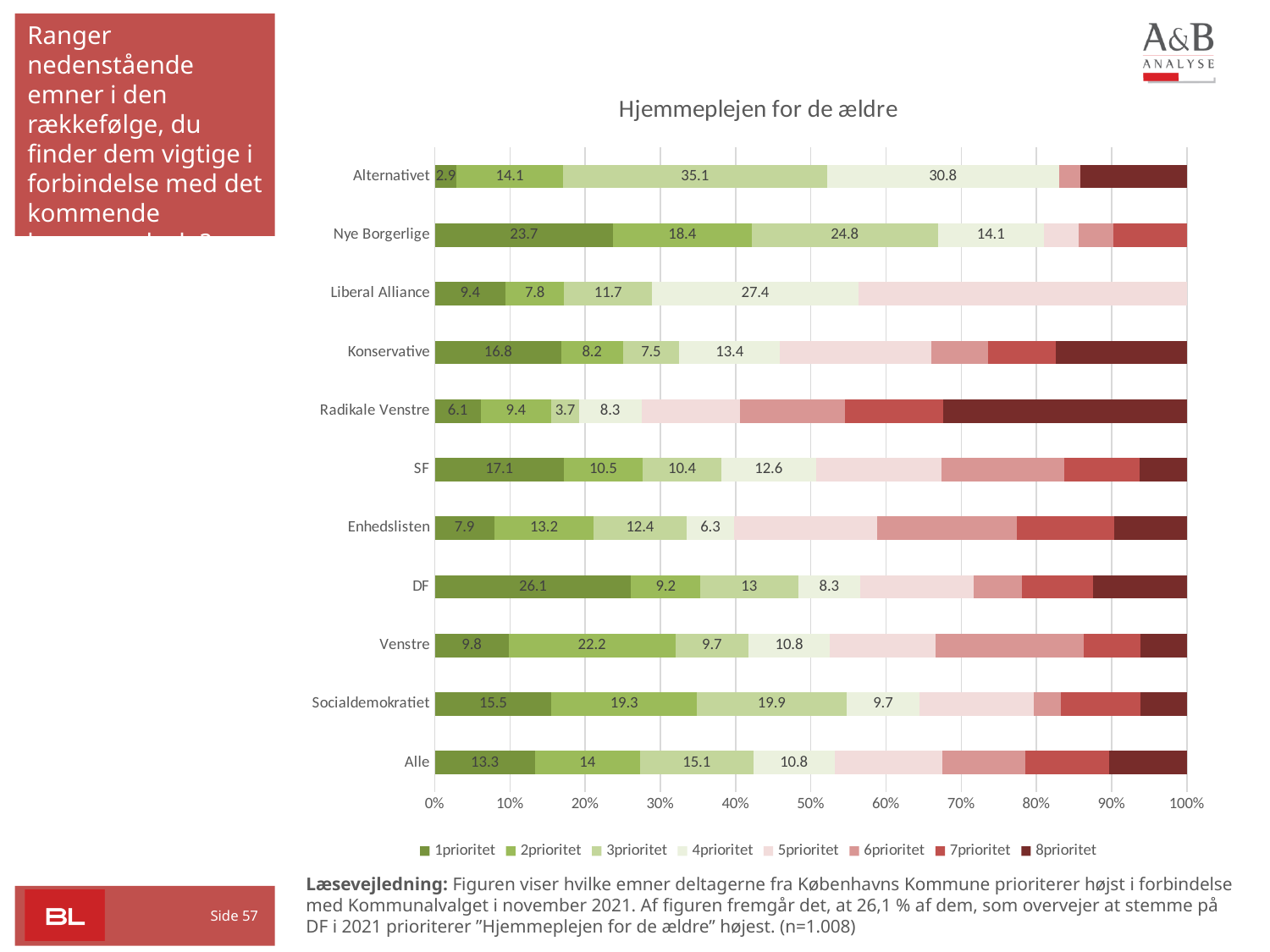
How many series does the legend list? 8 Which category has the lowest 1prioritet value? Alternativet What is the 3prioritet value for Alternativet? 35.1 What type of chart is shown on the slide? Stacked bar chart Which has a larger 2prioritet value, SF or Enhedslisten? Enhedslisten What is the difference between the 1prioritet values for Nye Borgerlige and Socialdemokratiet? 8.2 What is the title of the chart? Hjemmeplejen for de ældre What is the 4prioritet value for Liberal Alliance? 27.4 How many categories (parties/groups) are shown on the y axis? 11 Which category has the highest 1prioritet value? DF What is the 1prioritet value for DF? 26.1 What is the 2prioritet value for Venstre? 22.2